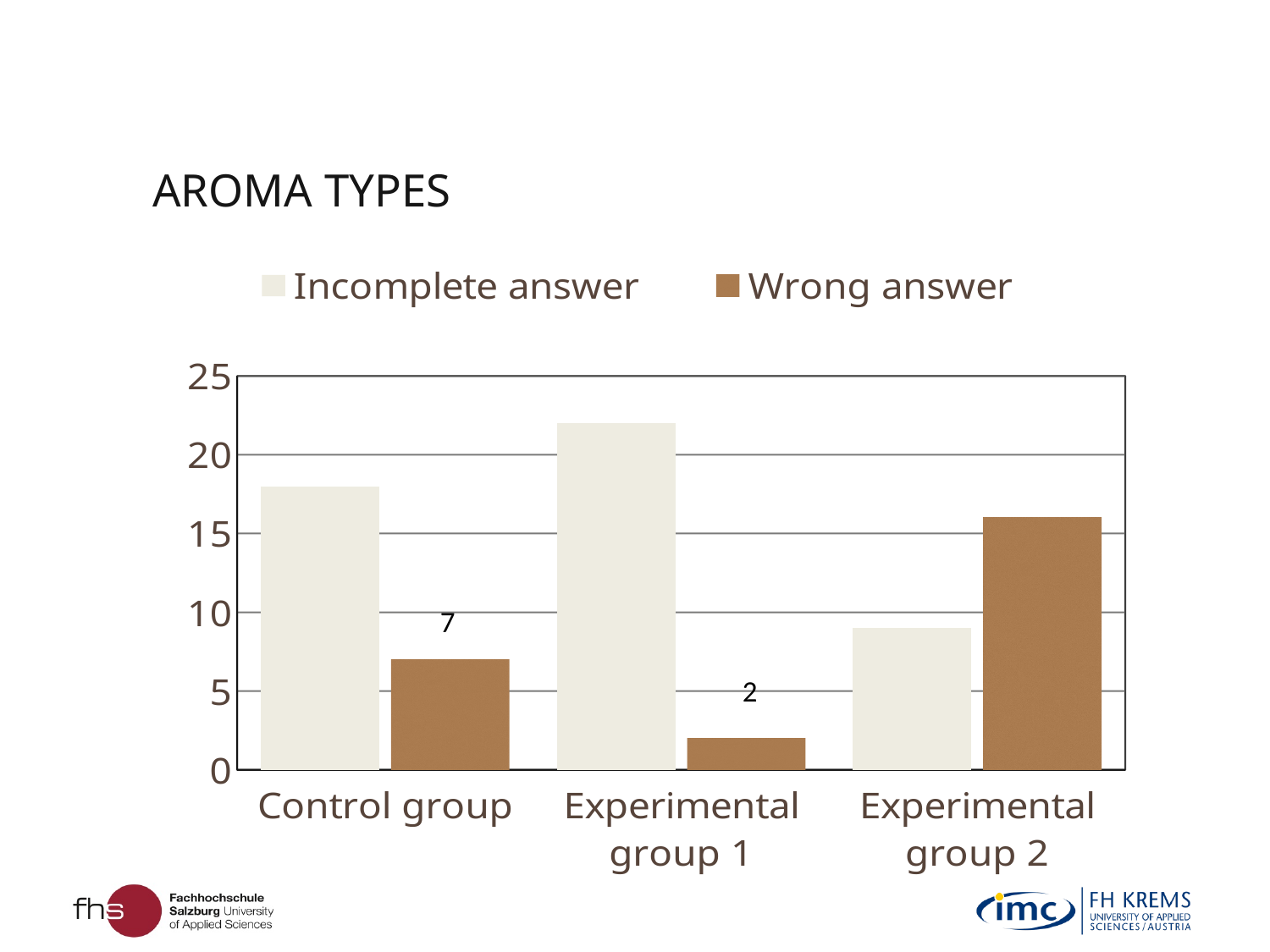
How many groups are shown on the x axis? 3 Which group has the highest Incomplete answer value? Experimental group 1 What is the value for Wrong answer in the Control group? 7 Is the Incomplete answer value for Experimental group 2 greater or less than 10? less What is the difference between the Wrong answer values for the Control group and Experimental group 1? 5 Which group has the lowest Incomplete answer value? Experimental group 2 What is the value for Wrong answer in Experimental group 1? 2 Is the Incomplete answer value for Experimental group 1 greater or less than 20? greater How many series does the legend list? 2 Which group has the lowest Wrong answer value? Experimental group 1 In Experimental group 2, which is larger: the Incomplete answer value or the Wrong answer value? Wrong answer Is the Wrong answer value for Experimental group 2 greater or less than 15? greater